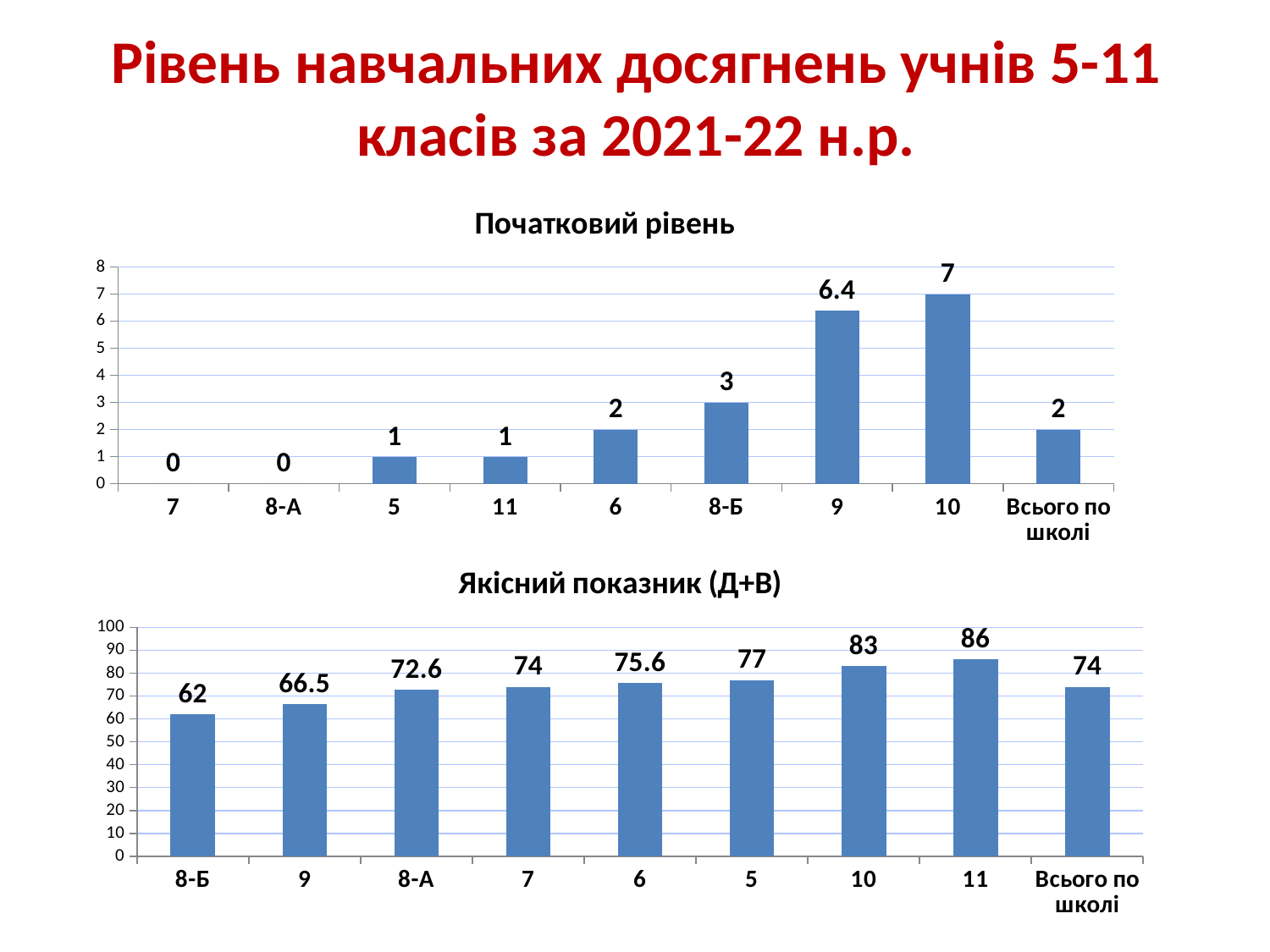
In the "Початковий рівень" chart, which category has the highest value? 10 What kind of chart is the "Початковий рівень" chart? bar chart In the "Якісний показник (Д+В)" chart, which is larger: the value for class 10 or the value for "Всього по школі"? 10 In the "Якісний показник (Д+В)" chart, what is the value for class 8-А? 72.6 In the "Якісний показник (Д+В)" chart, do the values rise or fall from left to right across the class categories (8-Б to 11)? rise In the "Якісний показник (Д+В)" chart, what is the difference between the values for class 11 and class 9? 19.5 In the "Якісний показник (Д+В)" chart, which category has the highest value? 11 In the "Початковий рівень" chart, what is the value for class 9? 6.4 In the "Початковий рівень" chart, what is the value for "Всього по школі"? 2 In the "Якісний показник (Д+В)" chart, which category has the lowest value? 8-Б In the "Початковий рівень" chart, what is the difference between the values for class 10 and class 8-Б? 4 In the "Початковий рівень" chart, how many categories are shown on the x axis? 9